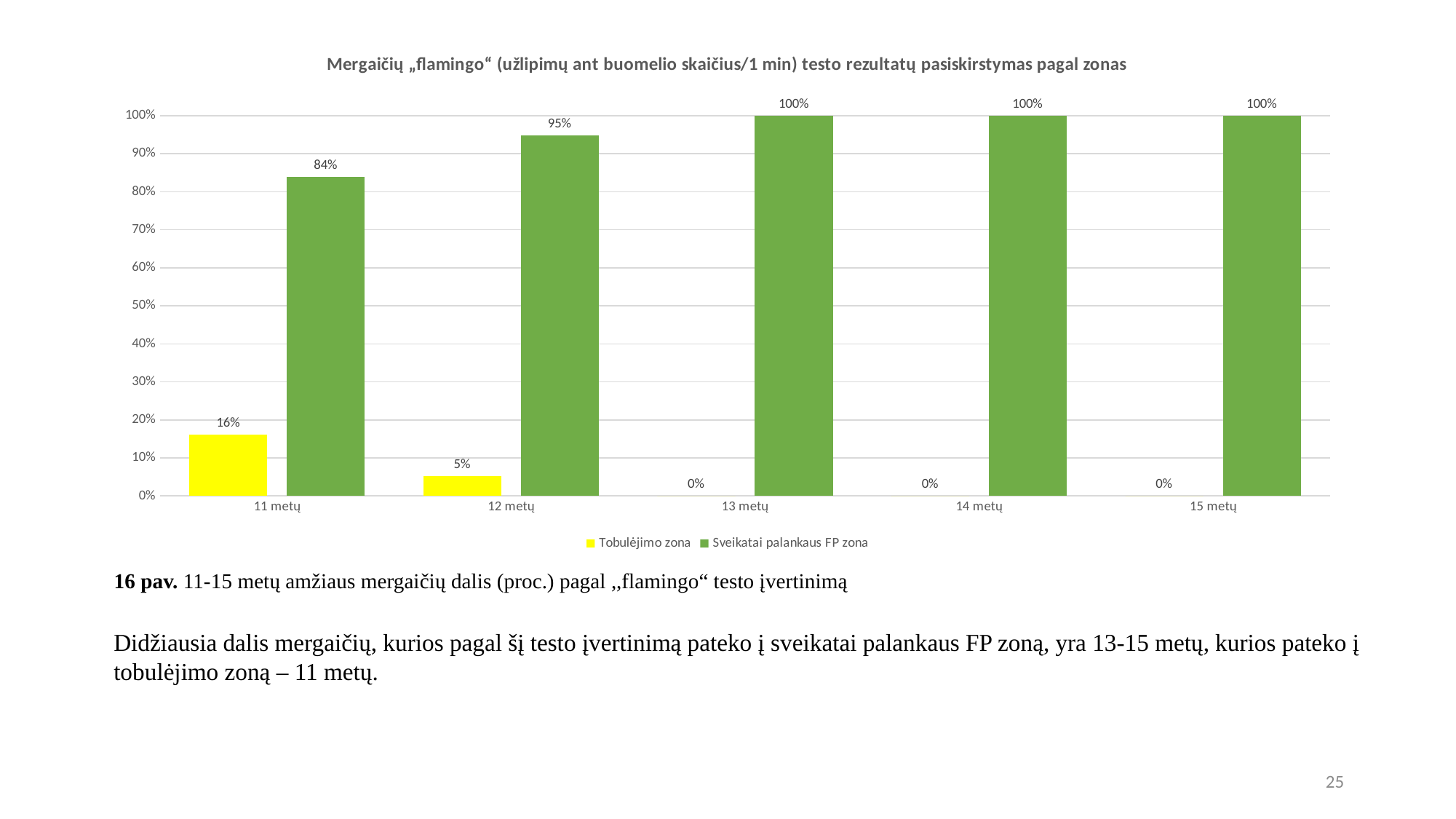
Do the Sveikatai palankaus FP zona values rise or fall from 11 metų to 15 metų? Rise Which age group has the lowest value for Sveikatai palankaus FP zona? 11 metų Which age group has the highest value for Tobulėjimo zona? 11 metų How many series does the legend list? 2 What is the difference between the Sveikatai palankaus FP zona values for 12 metų and 11 metų? 11% What is the value for Tobulėjimo zona at 11 metų? 16% Which is larger: Tobulėjimo zona at 11 metų or Tobulėjimo zona at 12 metų? Tobulėjimo zona at 11 metų What kind of chart is shown on the slide? Bar chart What is the value for Sveikatai palankaus FP zona at 12 metų? 95% How many age groups are shown on the x axis? 5 What is the value for Sveikatai palankaus FP zona at 11 metų? 84% What is the value for Tobulėjimo zona at 13 metų? 0%